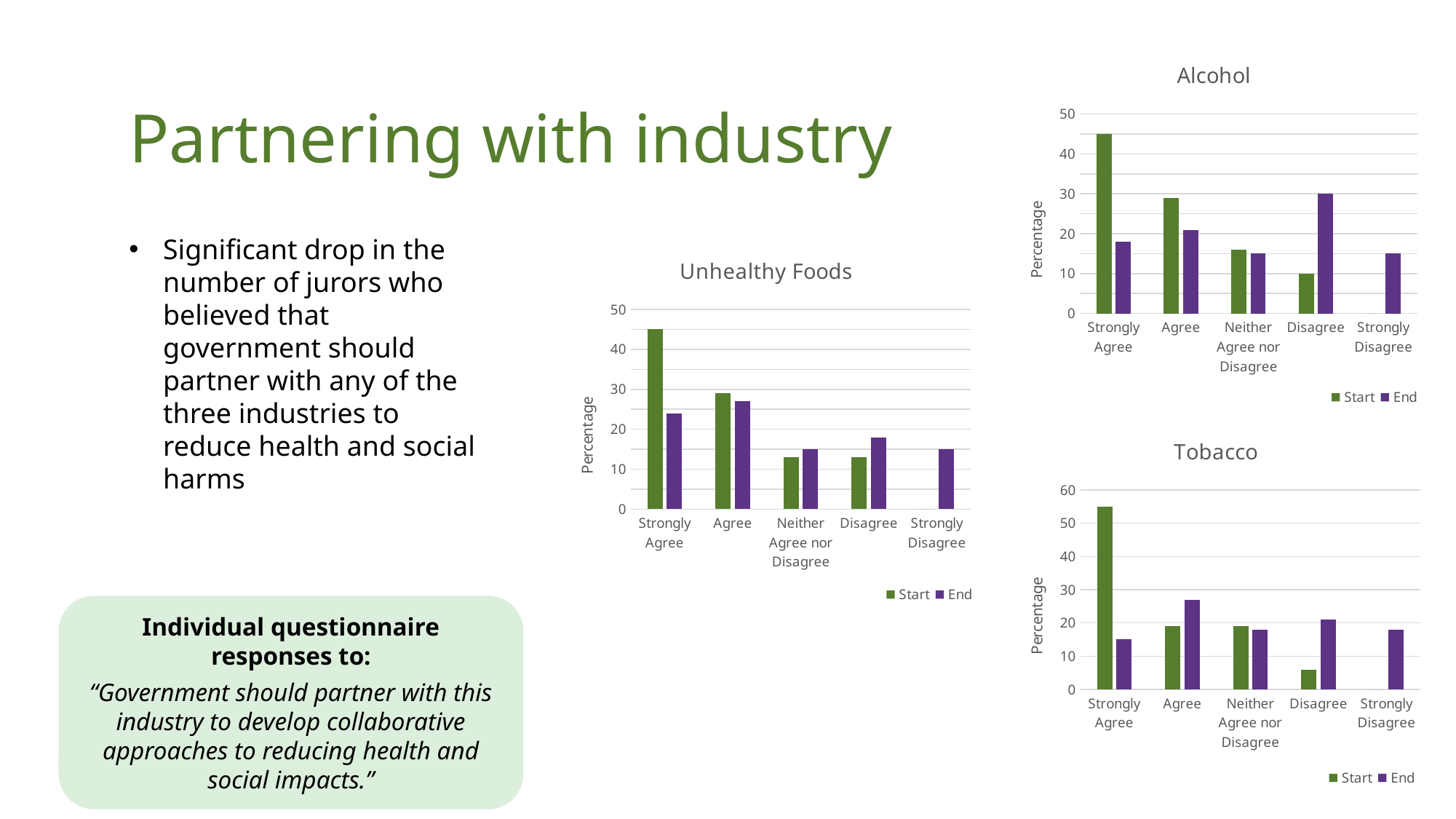
What kind of chart is the Unhealthy Foods chart? bar chart In the Alcohol chart, for Disagree, which is larger: the Start bar or the End bar? End In the Tobacco chart, for Agree, which is larger: the Start bar or the End bar? End In the Alcohol chart, is the End value for Disagree greater or less than 20? greater How many response categories are shown on the x axis of the Tobacco chart? 5 In the Tobacco chart, is the Start value for Strongly Agree greater or less than 50? greater How many series does the legend of the Alcohol chart list? 2 In the Unhealthy Foods chart, is the Start value for Strongly Agree greater or less than 40? greater In the Unhealthy Foods chart, which category has the highest Start bar? Strongly Agree What are the two legend entries in the Unhealthy Foods chart? Start and End In the Alcohol chart, do the Start bars rise or fall from Strongly Agree to Strongly Disagree? fall